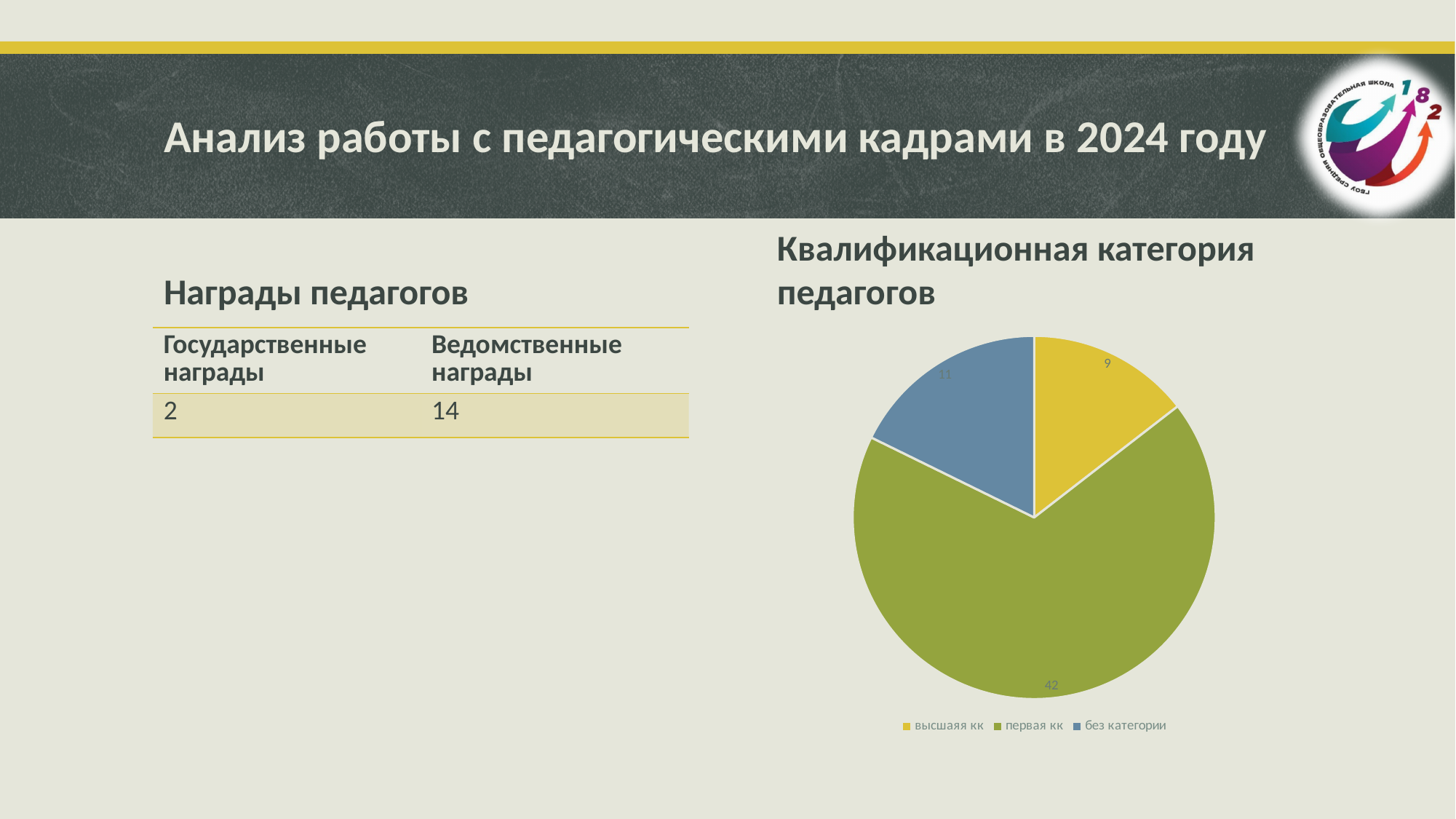
In the pie chart "Квалификационная категория педагогов", what is the value for "без категории"? 11 What is the total of all slices in the pie chart "Квалификационная категория педагогов"? 62 In the pie chart "Квалификационная категория педагогов", what is the difference between the values for "без категории" and "высшая кк"? 2 In the pie chart "Квалификационная категория педагогов", what colour is the slice for "первая кк"? green In the pie chart "Квалификационная категория педагогов", what is the value for "высшая кк"? 9 What kind of chart is shown under the title "Квалификационная категория педагогов"? pie chart How many categories does the pie chart "Квалификационная категория педагогов" show? 3 In the pie chart "Квалификационная категория педагогов", which is larger: "без категории" or "высшая кк"? без категории In the pie chart "Квалификационная категория педагогов", what is the value for "первая кк"? 42 In the pie chart "Квалификационная категория педагогов", what is the difference between the values for "первая кк" and "без категории"? 31 Which category has the largest slice in the pie chart "Квалификационная категория педагогов"? первая кк Which category has the smallest slice in the pie chart "Квалификационная категория педагогов"? высшаяя кк